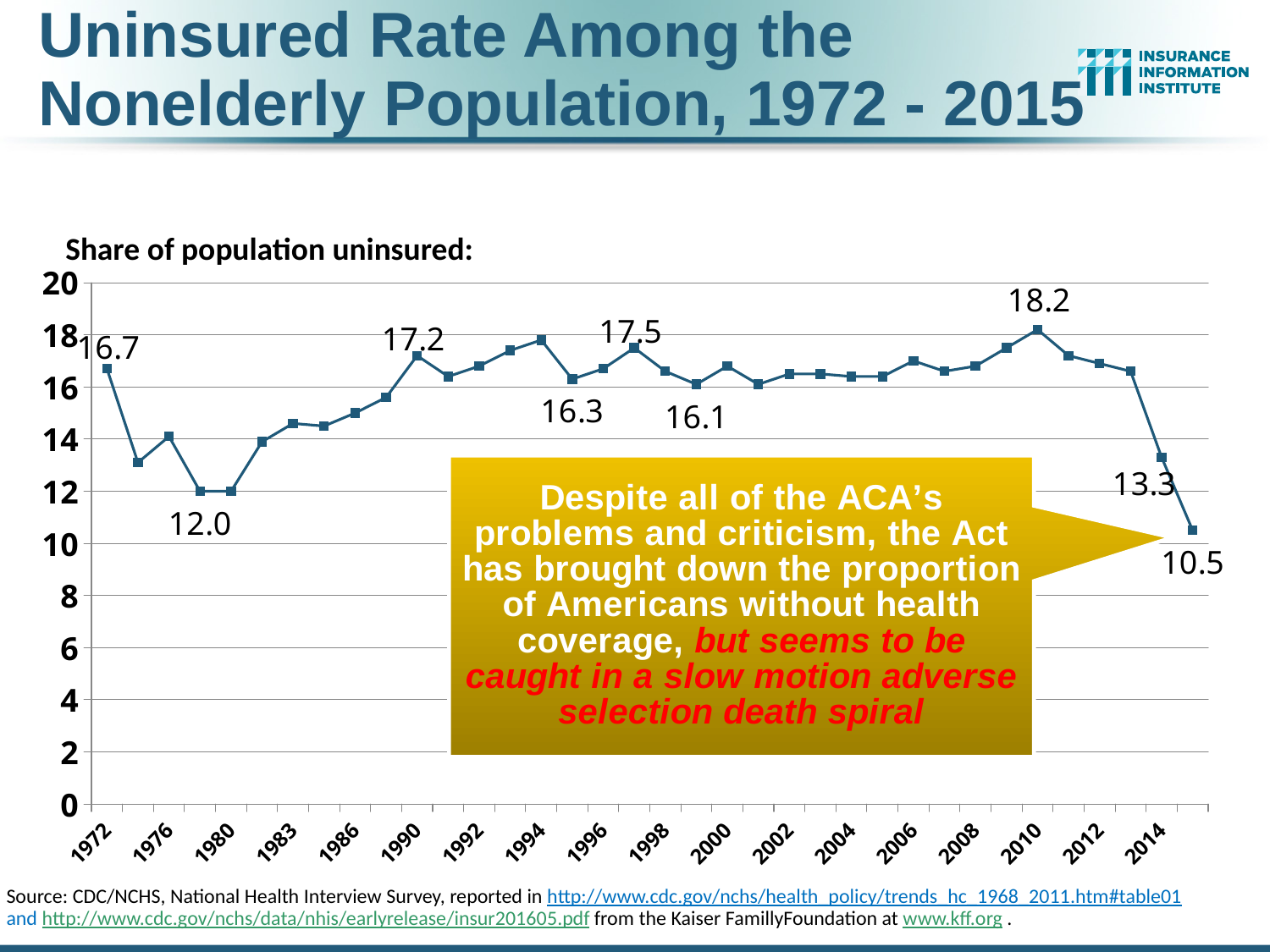
What was the uninsured rate in 2010? 18.2 What label appears above the chart describing what is plotted? Share of population uninsured: What is the value of the last data point on the chart (2015)? 10.5 Is the value for 1976 greater or less than 16? less By how much did the uninsured rate fall from 2010 (18.2) to 2015 (10.5)? 7.7 What was the uninsured rate in 1972? 16.7 What type of chart is shown on the slide? line chart In which year does the uninsured rate reach its highest value? 2010 Which year had a higher uninsured rate, 1972 or 1990? 1990 What was the uninsured rate in 1990? 17.2 What is the lowest value labeled on the chart? 10.5 What was the uninsured rate in 2014? 13.3